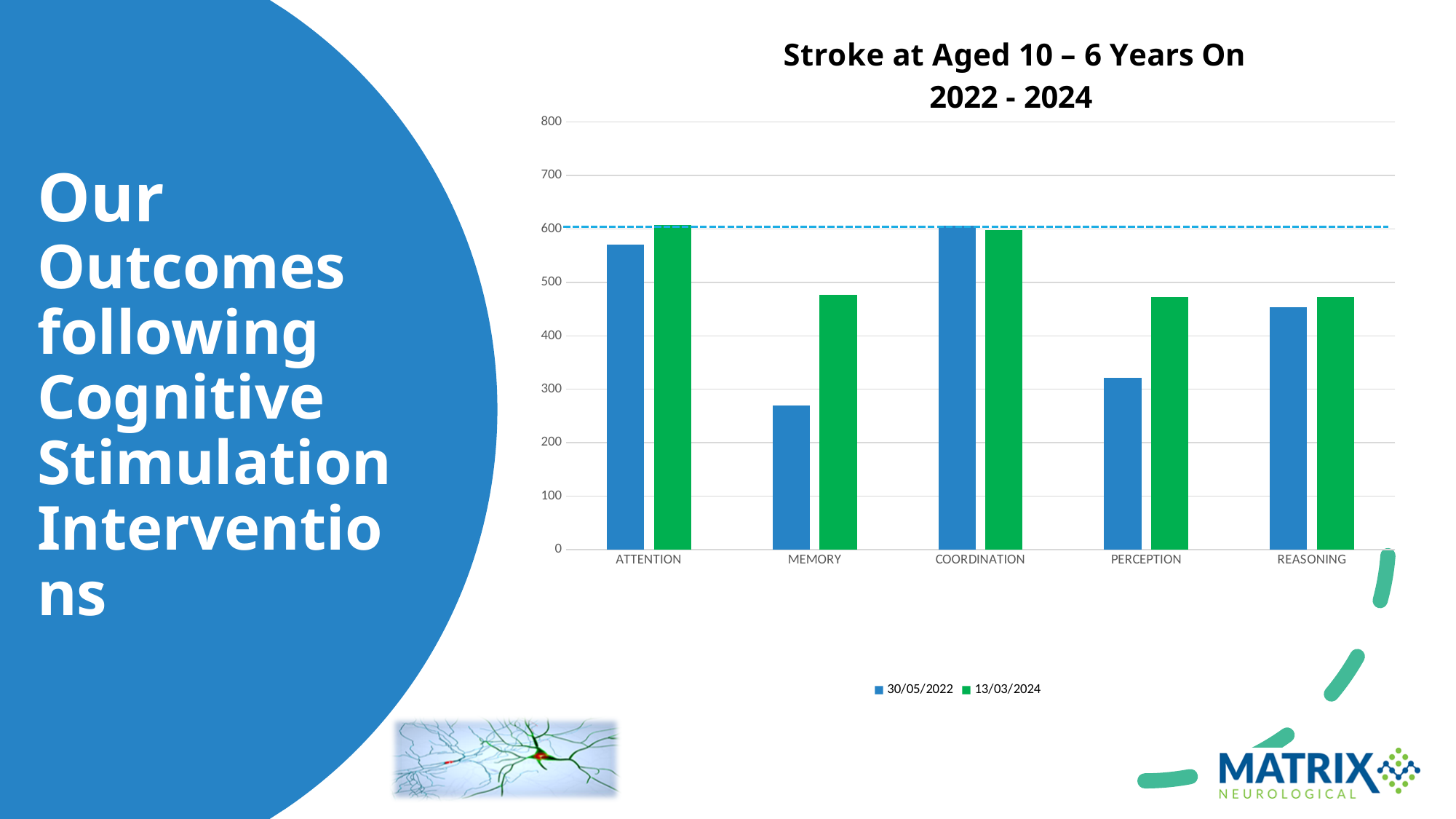
What kind of chart is shown on the slide? bar chart Is the 30/05/2022 value for MEMORY greater or less than 300? less Is the 13/03/2024 value for PERCEPTION greater or less than 400? greater Is the 30/05/2022 value for ATTENTION greater or less than 500? greater Which category has the lowest value for the 30/05/2022 series? MEMORY For PERCEPTION, which series has the larger value, 30/05/2022 or 13/03/2024? 13/03/2024 For MEMORY, which series has the larger value, 30/05/2022 or 13/03/2024? 13/03/2024 Which two dates are listed in the chart's legend? 30/05/2022 and 13/03/2024 What is the title of the chart? Stroke at Aged 10 – 6 Years On 2022 - 2024 How many categories are shown on the x axis of the chart? 5 Which category has the highest value for the 30/05/2022 series? COORDINATION How many series does the chart's legend list? 2